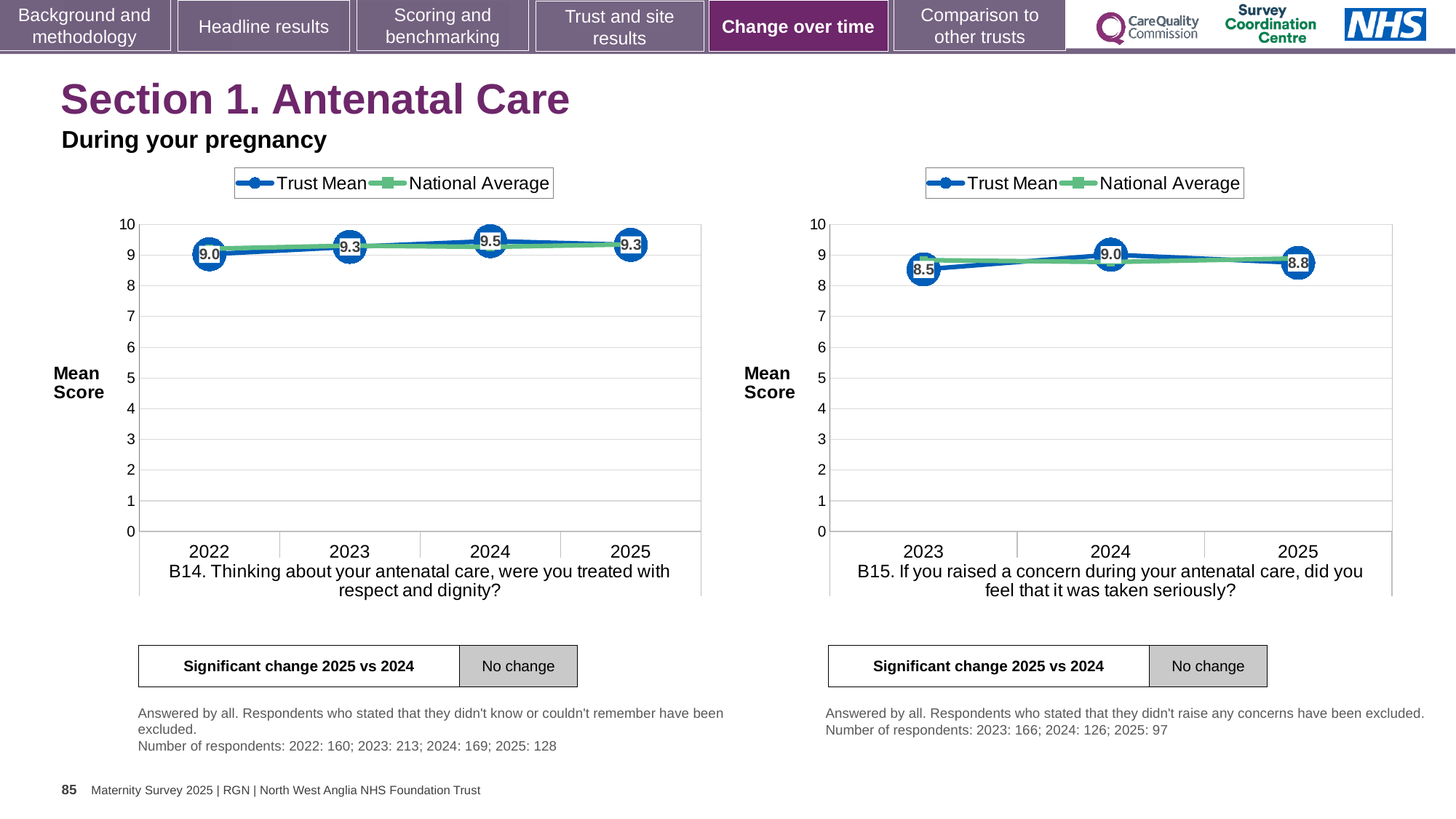
How many years are shown on the x axis of the B14 chart (left)? 4 In the B14 chart (left), is the Trust Mean score for 2022 or 2024 larger? 2024 What kind of chart is the B14 chart (left)? Line chart In the B15 chart (right), is the Trust Mean value for 2023 greater or less than 9? less In the B14 chart (left), what is the Trust Mean score for 2022? 9.0 In the B15 chart (right), what is the difference between the Trust Mean scores for 2024 and 2023? 0.5 How many series does the legend of the B15 chart (right) list? 2 In the B14 chart (left), what is the Trust Mean score for 2024? 9.5 In the B15 chart (right), what is the Trust Mean score for 2023? 8.5 In the B15 chart (right), what is the Trust Mean score for 2025? 8.8 In the B14 chart (left), which year has the highest Trust Mean score? 2024 In the B15 chart (right), which year has the lowest Trust Mean score? 2023